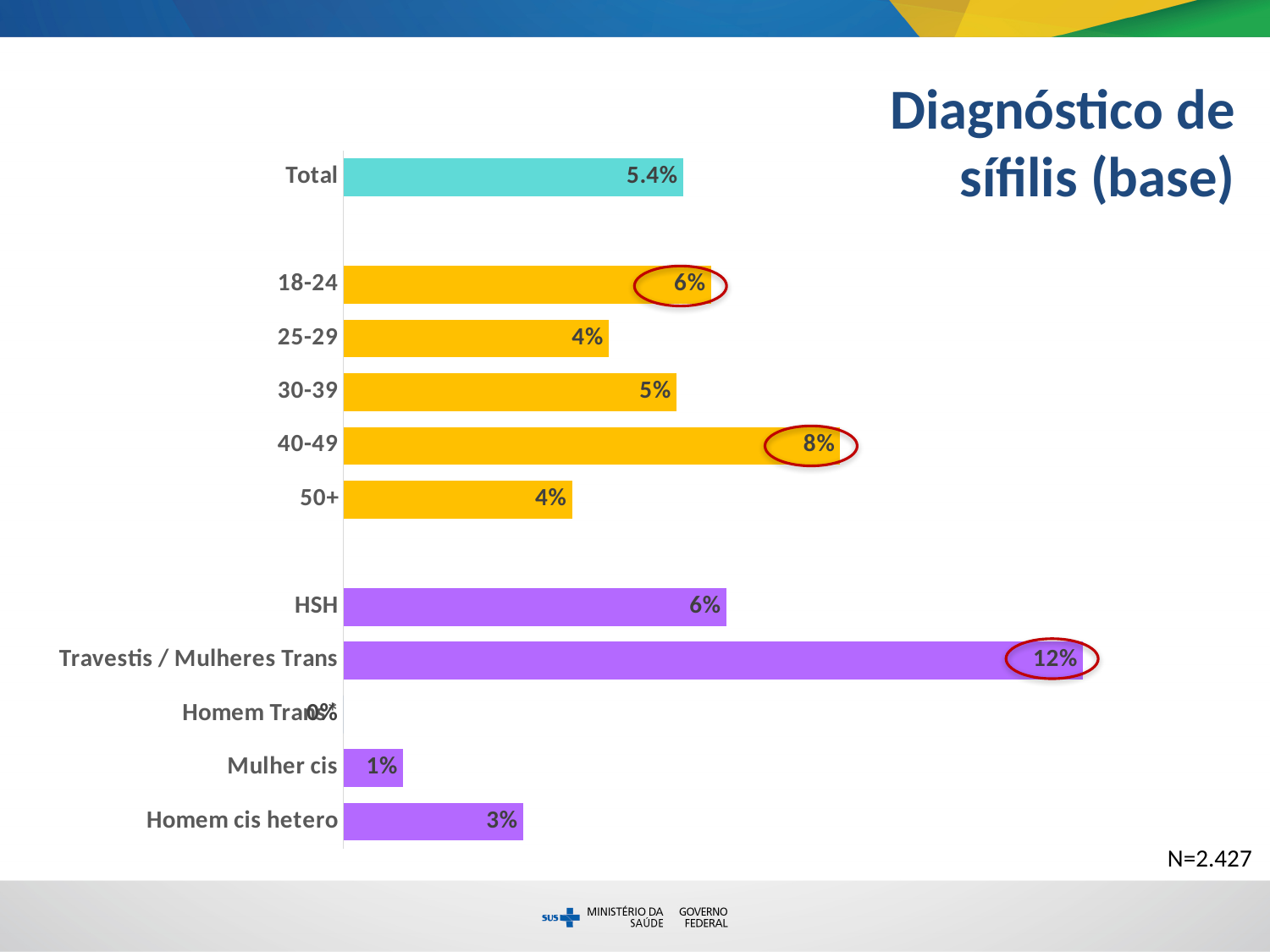
What is the difference between the values for Travestis / Mulheres Trans and HSH? 6% Which is larger, the value for 18-24 or the value for 25-29? 18-24 What is the value for the 40-49 age group? 8% What is the difference between the values for 40-49 and 30-39? 3% What is the value for Travestis / Mulheres Trans? 12% What is the value for Total? 5.4% Among the age groups (18-24 to 50+), which has the highest value? 40-49 Which category has the highest value? Travestis / Mulheres Trans What is the value for Mulher cis? 1% What kind of chart is shown on the slide? Bar chart How many categories are plotted in the chart, including Total? 11 Which is larger, the value for HSH or the value for Homem cis hetero? HSH